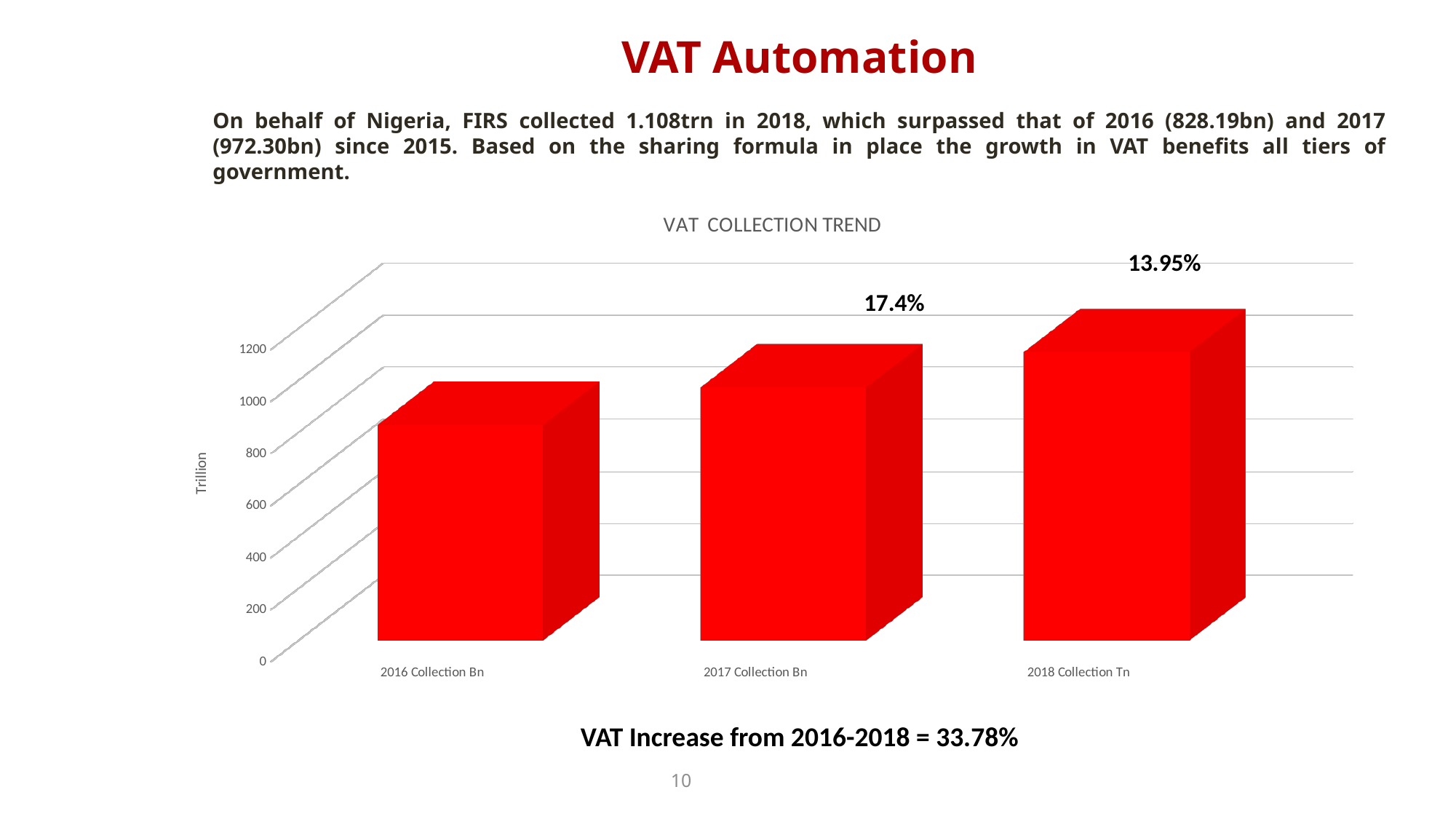
What percentage label is printed above the 2018 Collection Tn bar? 13.95% Is the value for 2016 Collection Bn greater or less than 400? greater What is the title of the chart? VAT COLLECTION TREND How many bars (categories) does the chart show? 3 What is the label on the vertical axis of the chart? Trillion What kind of chart is shown on the slide? bar chart Do the bar values rise or fall from 2016 to 2018? rise Is the value for 2018 Collection Tn greater or less than 600? greater What percentage label is printed above the 2017 Collection Bn bar? 17.4% Which bar is taller, 2017 Collection Bn or 2016 Collection Bn? 2017 Collection Bn Which category has the tallest bar? 2018 Collection Tn Which category has the shortest bar? 2016 Collection Bn